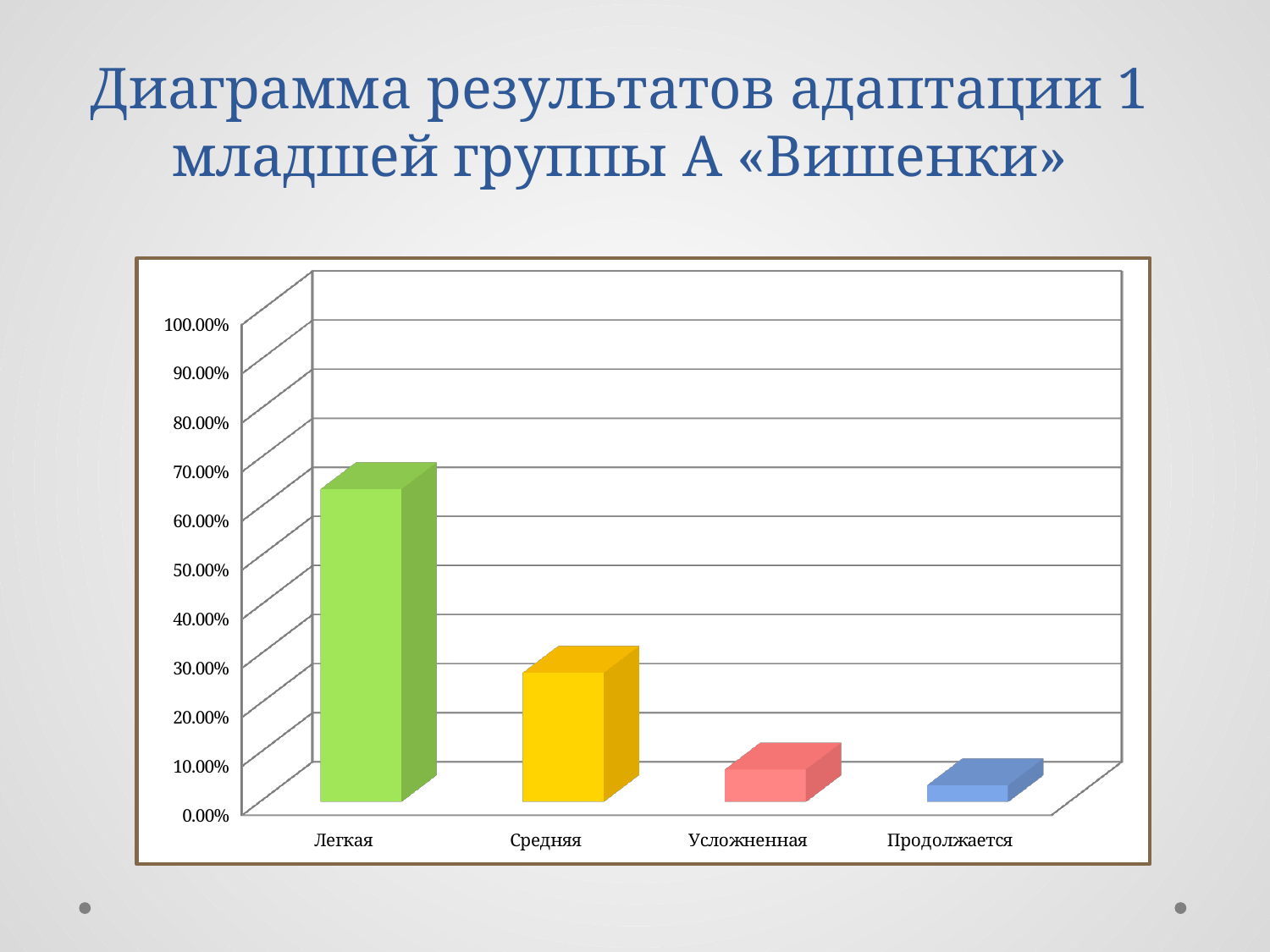
How many categories are shown on the x axis of the chart? 4 Is the value for Легкая greater or less than 50.00%? greater Do the values rise or fall moving from left to right along the x axis? fall Is the value for Усложненная greater or less than 10.00%? less Which is larger, the value for Легкая or the value for Средняя? Легкая Which category has the lowest value in the chart? Продолжается What colour is the bar for Легкая? green Is the value for Средняя greater or less than 40.00%? less Which is larger, the value for Средняя or the value for Усложненная? Средняя Which category has the highest value in the chart? Легкая What kind of chart is shown on the slide? bar chart